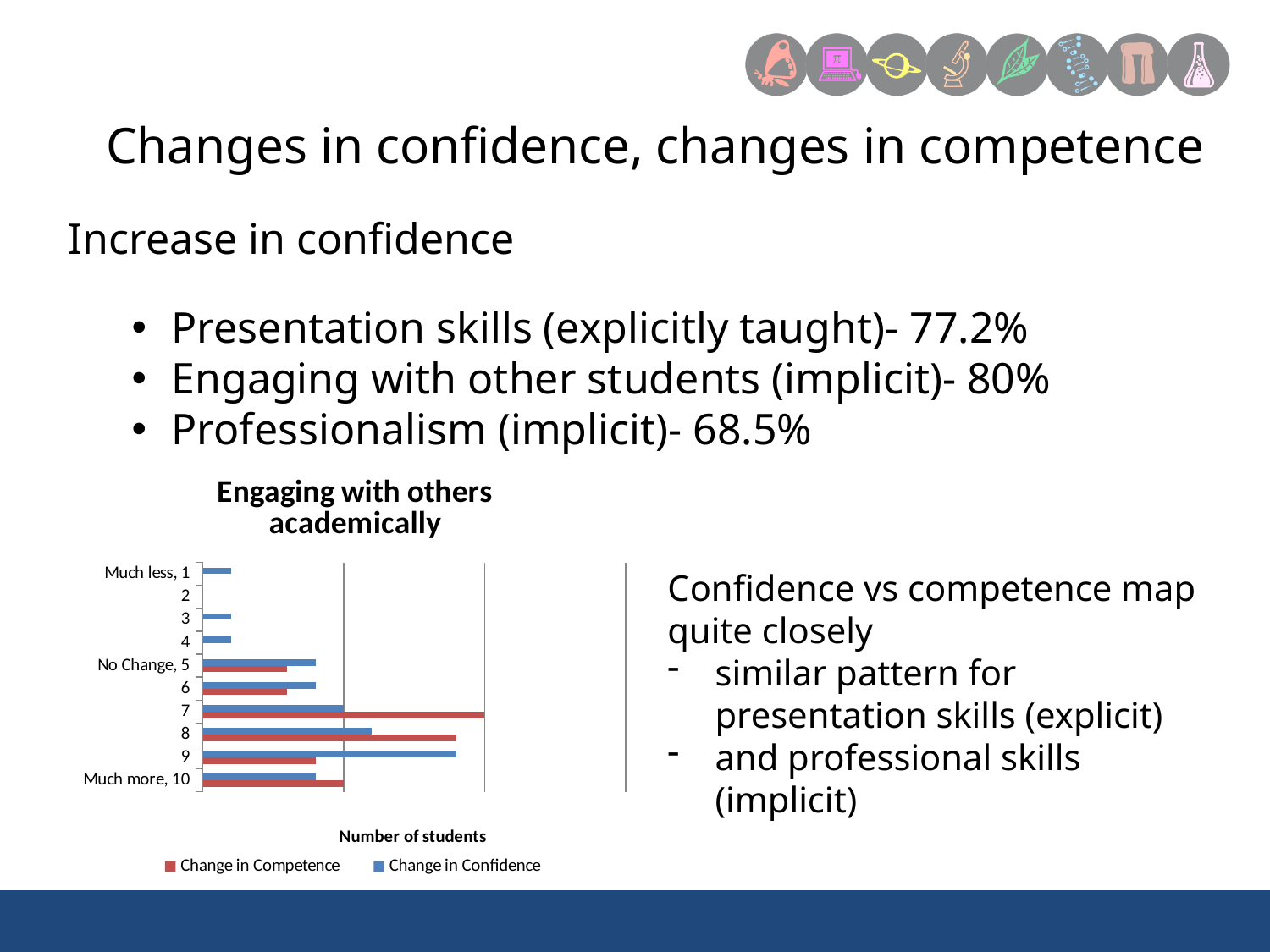
Which category has the highest value for Change in Confidence? 9 What is the label on the horizontal axis of the chart? Number of students How many categories are shown on the vertical axis of the chart? 10 For Change in Confidence, which is larger: the value for category 9 or the value for category 'Much more, 10'? 9 What is the title of the chart? Engaging with others academically How many series does the chart's legend list? 2 For the category 'No Change, 5', which is larger: Change in Competence or Change in Confidence? Change in Confidence What kind of chart is shown on the slide? bar chart Which category has the highest value for Change in Competence? 7 For category 8, which is larger: Change in Competence or Change in Confidence? Change in Competence